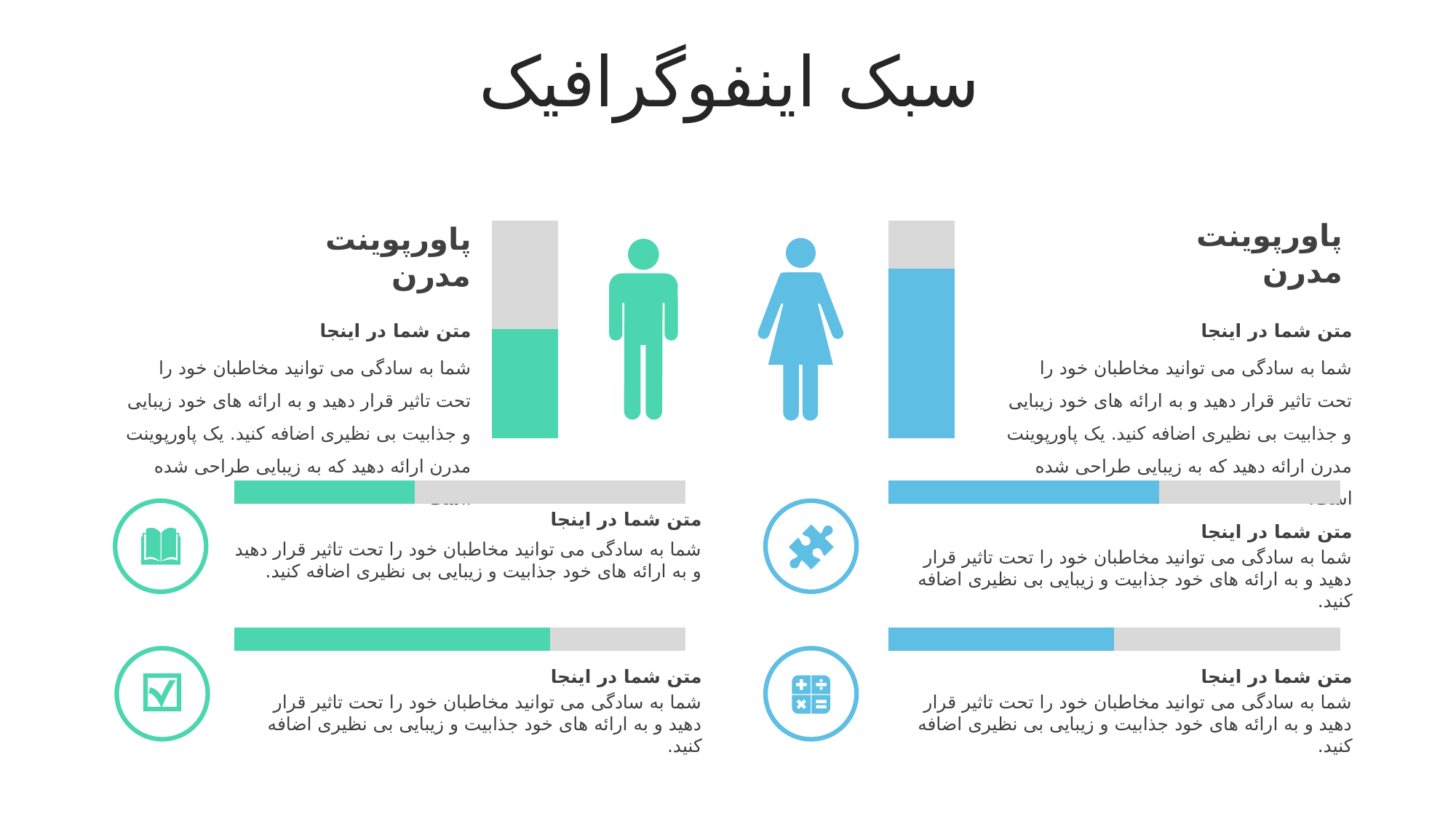
Of the two green horizontal progress bars on the left side, which is filled further, the upper one or the lower one? the lower one What colour is the fill of the vertical bar next to the male icon? green Is the blue vertical bar beside the female icon filled more or less than half of its height? more What colour is the fill of the vertical bar next to the female icon? blue How many horizontal progress bars are shown on the slide? 4 Of the two vertical bars beside the person icons, which is filled higher, the green one on the left or the blue one on the right? the blue one on the right Of the two blue horizontal progress bars on the right side, which is filled further, the upper one or the lower one? the upper one